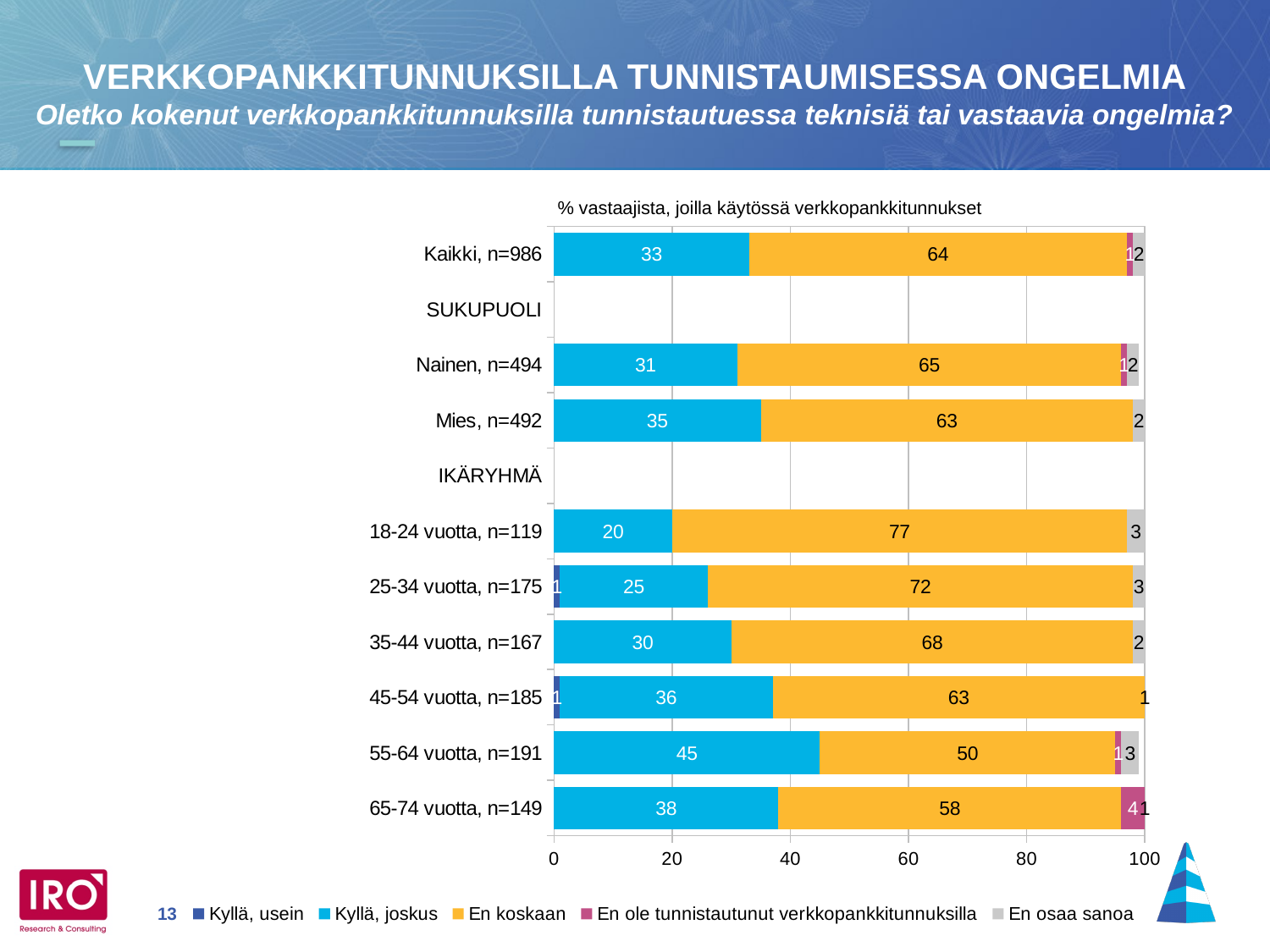
Which has the larger "Kyllä, joskus" value, Nainen, n=494 or Mies, n=492? Mies, n=492 What is the "Kyllä, joskus" value for Kaikki, n=986? 33 How many age groups (IKÄRYHMÄ) are plotted in the chart? 6 How many series does the legend list? 5 What is the difference between the "En koskaan" values for 18-24 vuotta and 55-64 vuotta? 27 What is the text shown above the chart describing the values? % vastaajista, joilla käytössä verkkopankkitunnukset Is the "Kyllä, joskus" value for Mies, n=492 greater or less than 40? less What is the "En ole tunnistautunut verkkopankkitunnuksilla" value for 65-74 vuotta, n=149? 4 What is the "En koskaan" value for 18-24 vuotta, n=119? 77 What type of chart is shown on the slide? stacked bar chart Which age group has the highest "Kyllä, joskus" value? 55-64 vuotta, n=191 Which age group has the lowest "Kyllä, joskus" value? 18-24 vuotta, n=119